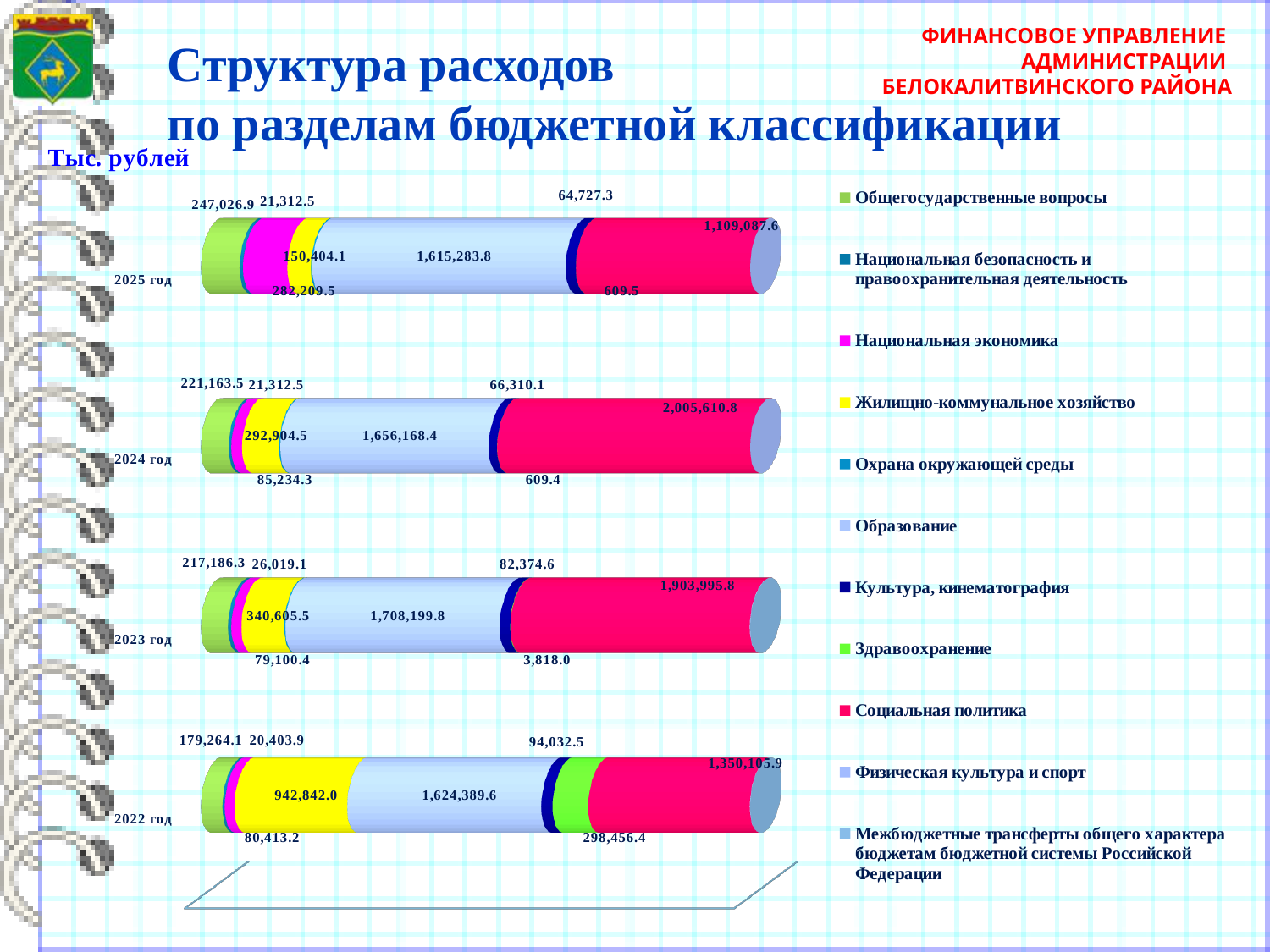
What is the difference between the Образование values for 2024 год and 2025 год? 40,884.6 What is the value for Образование in 2023 год? 1,708,199.8 In what units are the chart values given? Тыс. рублей In which year is the value for Социальная политика the highest? 2024 год What is the value for Культура, кинематография in 2022 год? 94,032.5 How many series does the legend list? 11 What is the value for Социальная политика in 2024 год? 2,005,610.8 What kind of chart is shown on the slide? Stacked bar chart How many years (bars) are shown in the chart? 4 Which year has the larger value for Социальная политика: 2022 год or 2025 год? 2022 год What is the value for Общегосударственные вопросы in 2022 год? 179,264.1 In which year is the value for Образование the highest? 2023 год